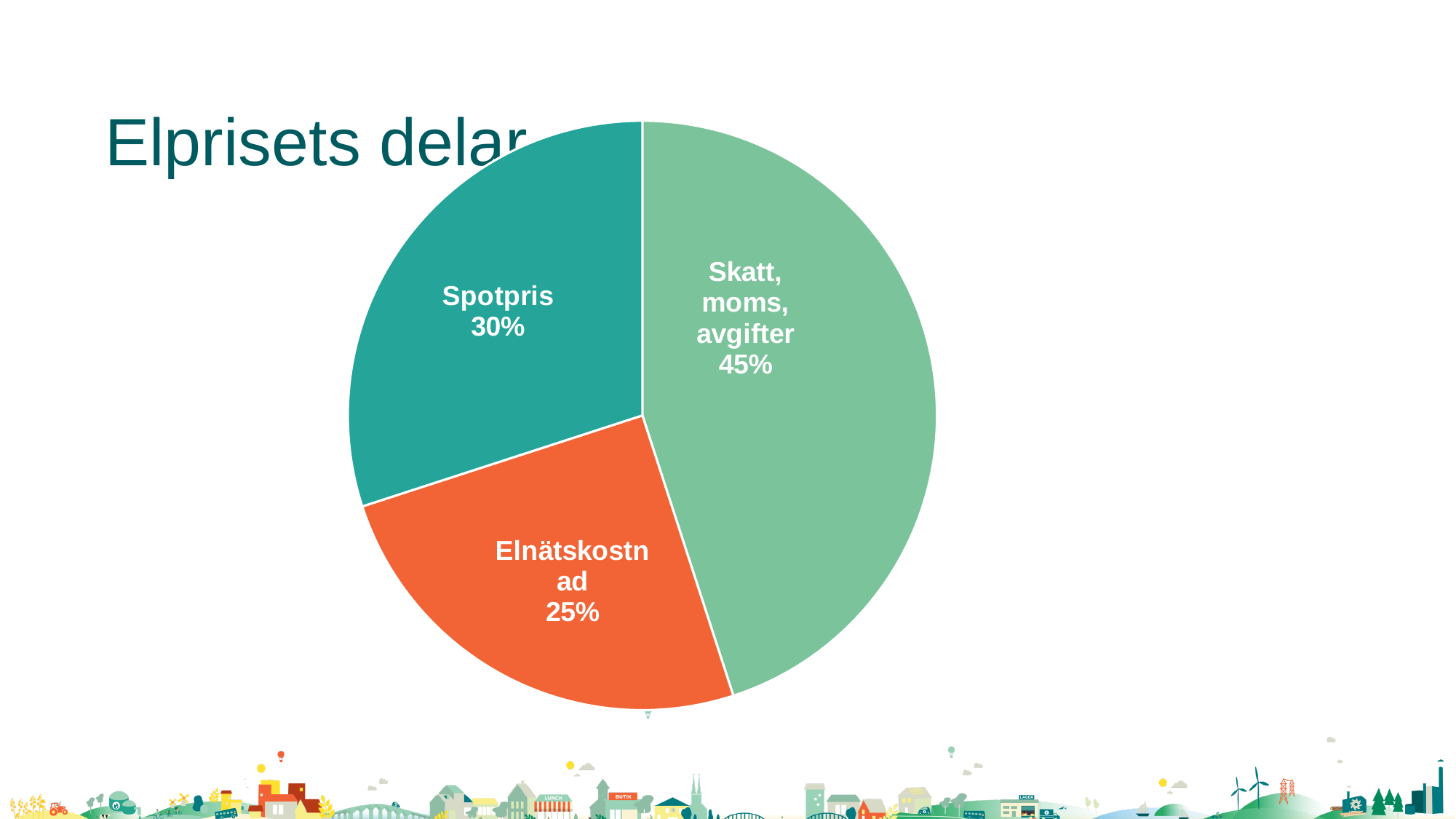
Which is larger, the Spotpris slice or the Elnätskostnad slice? Spotpris Which slice of the pie is the largest? Skatt, moms, avgifter How many slices does the pie chart have? 3 What is the difference in percentage points between Skatt, moms, avgifter and Spotpris? 15 What share of the pie does Spotpris represent? 30% What share of the pie does Elnätskostnad represent? 25% What is the difference in percentage points between Spotpris and Elnätskostnad? 5 What kind of chart is shown on the slide? Pie chart What is the title of the slide containing the pie chart? Elprisets delar What share of the pie does Skatt, moms, avgifter represent? 45% Which slice of the pie is the smallest? Elnätskostnad What colour is the Elnätskostnad slice? Orange